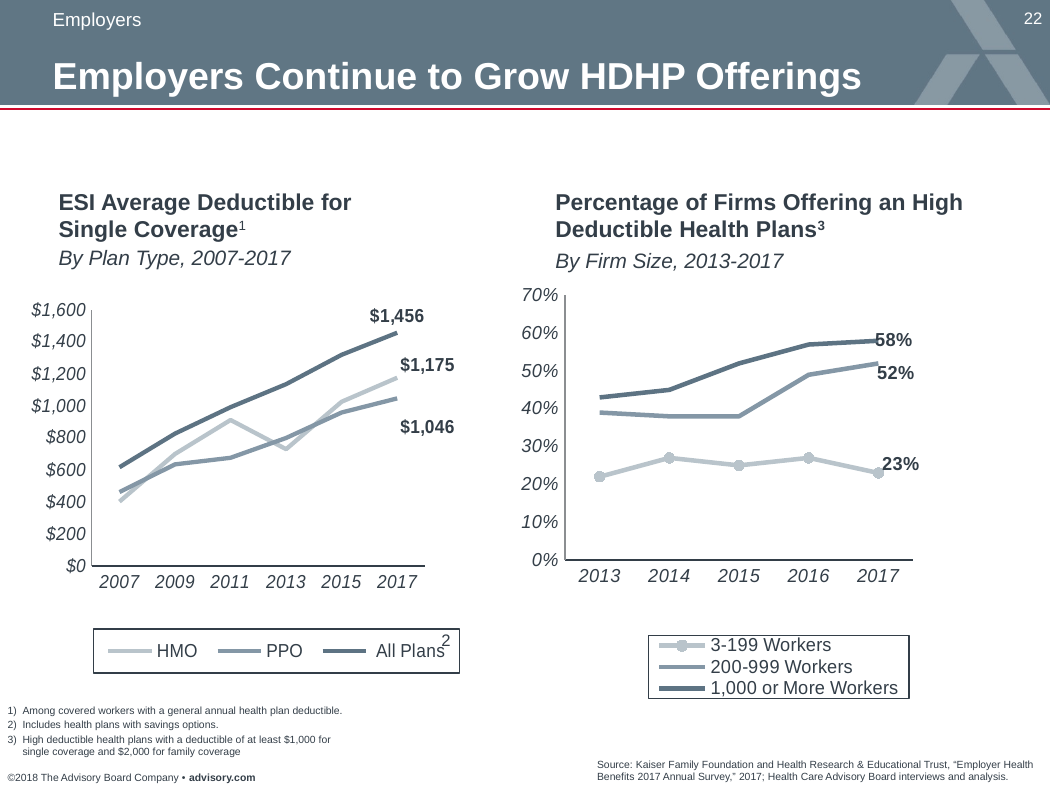
How many years are plotted on the x axis of the 'Percentage of Firms Offering an High Deductible Health Plans' chart? 5 In the 'Percentage of Firms Offering an High Deductible Health Plans' chart, what is the difference between the 1,000 or More Workers and 3-199 Workers values in 2017? 35 percentage points What kind of chart is the 'ESI Average Deductible for Single Coverage' chart on the left? Line chart In the 'ESI Average Deductible for Single Coverage' chart, what is the HMO value in 2017? $1,175 In the 'Percentage of Firms Offering an High Deductible Health Plans' chart, what is the value for 1,000 or More Workers in 2017? 58% How many series does the legend of the 'ESI Average Deductible for Single Coverage' chart list? 3 In the 'ESI Average Deductible for Single Coverage' chart, what is the difference between the All Plans and PPO values in 2017? $410 In the 'Percentage of Firms Offering an High Deductible Health Plans' chart, what is the value for 3-199 Workers in 2017? 23% In the 'ESI Average Deductible for Single Coverage' chart, is the All Plans value in 2007 greater or less than $800? less In the 'ESI Average Deductible for Single Coverage' chart, what is the PPO value in 2017? $1,046 In the 'ESI Average Deductible for Single Coverage' chart, what is the All Plans value in 2017? $1,456 In the 'Percentage of Firms Offering an High Deductible Health Plans' chart, does the 1,000 or More Workers line rise or fall from 2013 to 2017? Rises